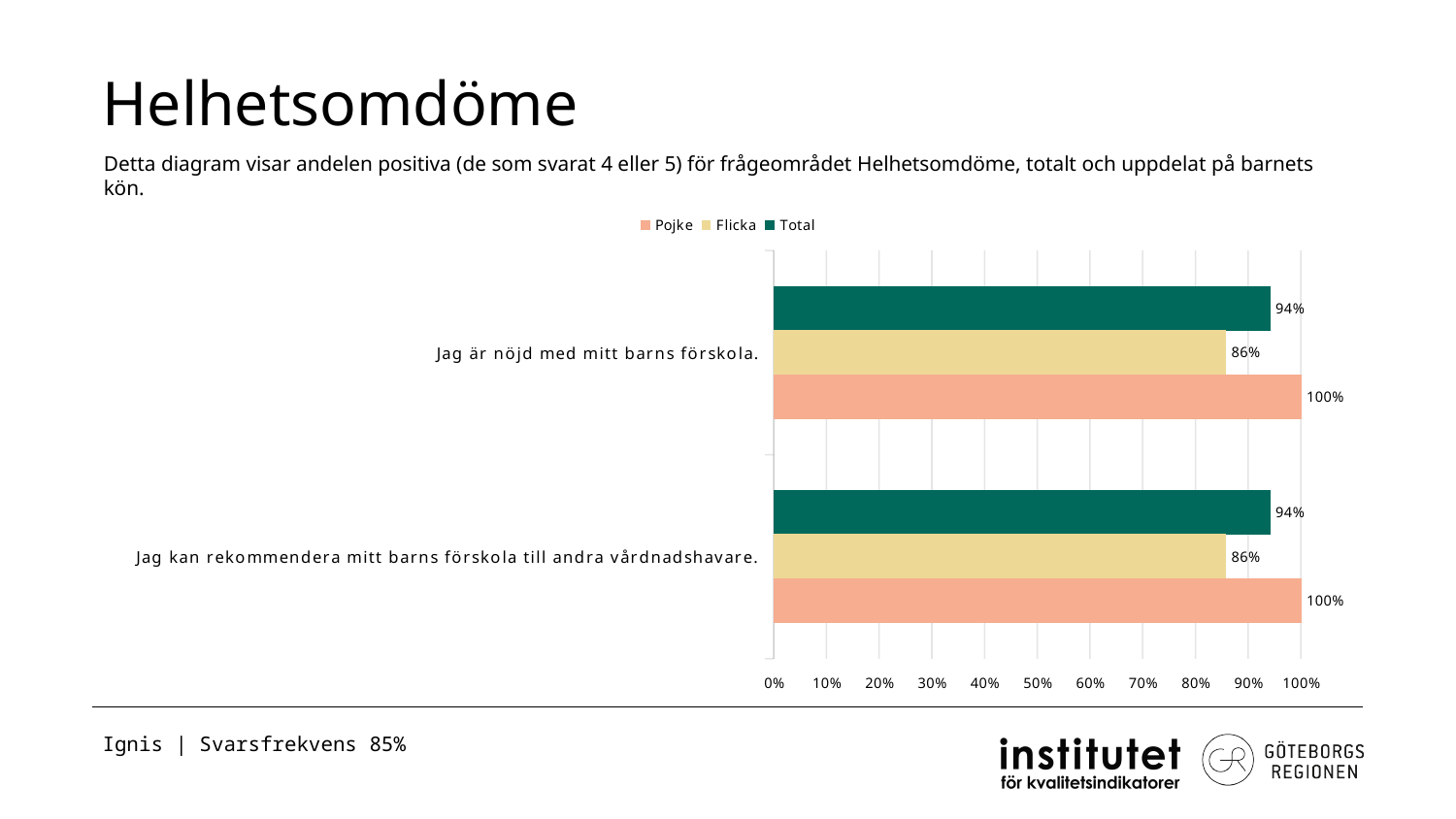
What are the legend entries of the chart? Pojke, Flicka, Total What is the value for Pojke for "Jag är nöjd med mitt barns förskola."? 100% How many categories (statements) are shown in the chart? 2 Which series has the highest value for "Jag kan rekommendera mitt barns förskola till andra vårdnadshavare."? Pojke Is the Total value for "Jag kan rekommendera mitt barns förskola till andra vårdnadshavare." larger or smaller than the Flicka value? larger What is the value for Flicka for "Jag kan rekommendera mitt barns förskola till andra vårdnadshavare."? 86% Is the Flicka value for "Jag är nöjd med mitt barns förskola." greater or less than 90%? less What is the difference between the Pojke and Flicka values for "Jag är nöjd med mitt barns förskola."? 14 percentage points What kind of chart is shown on the slide? bar chart How many series does the legend list? 3 What is the Total value for "Jag är nöjd med mitt barns förskola."? 94% Which series has the lowest value for "Jag är nöjd med mitt barns förskola."? Flicka